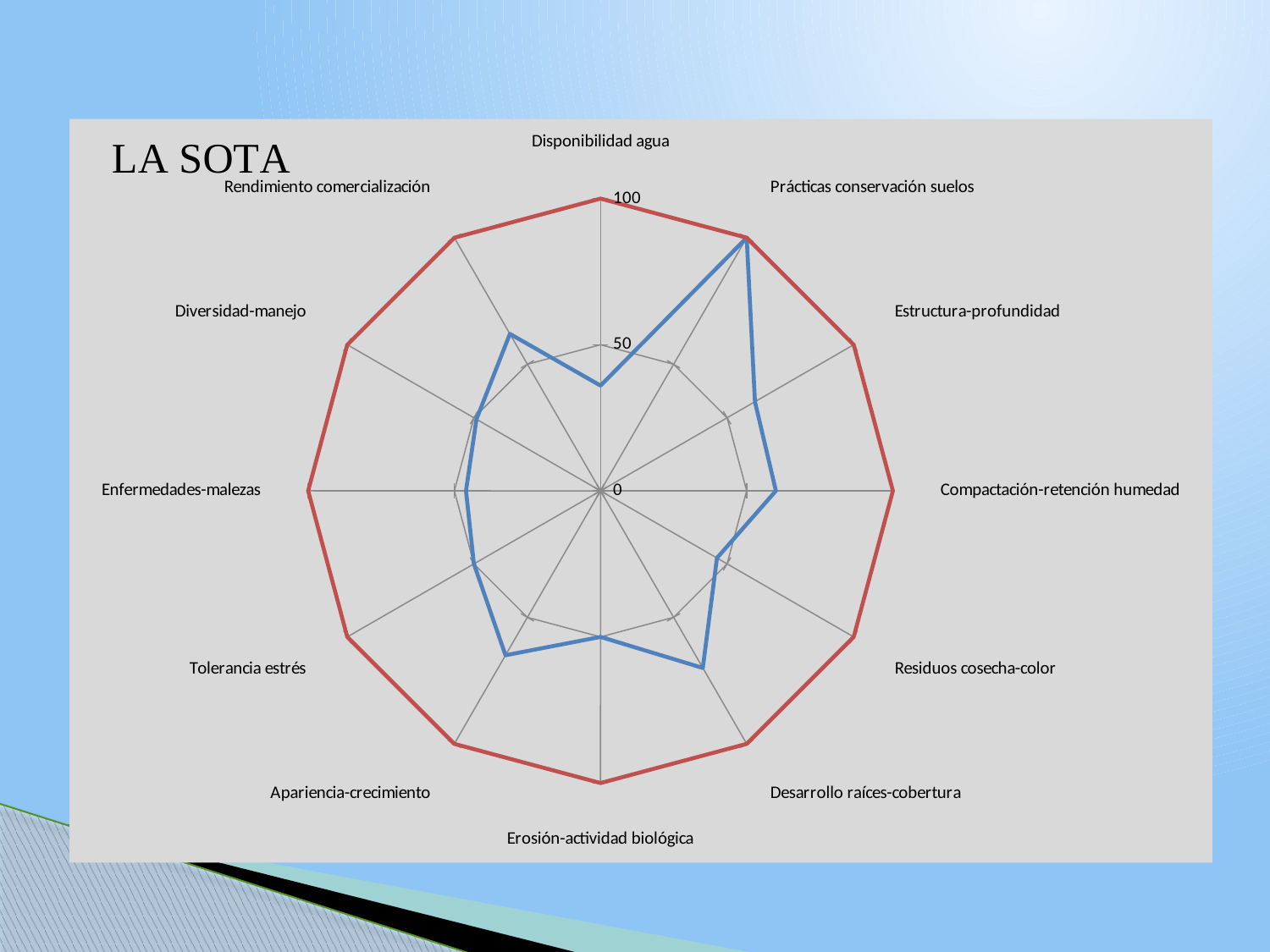
What is the highest value shown on the radial axis? 100 Which has the larger blue series value: Prácticas conservación suelos or Disponibilidad agua? Prácticas conservación suelos What is the value of the red series for Disponibilidad agua? 100 What kind of chart is shown on the slide? Radar chart What is the title of the chart? LA SOTA Is the blue series value for Disponibilidad agua greater or less than 50? less Is the blue series value for Prácticas conservación suelos greater or less than 50? greater Is the blue series value for Apariencia-crecimiento greater or less than 50? greater For which category does the blue series reach its highest value? Prácticas conservación suelos How many categories (axes) does the radar chart have? 12